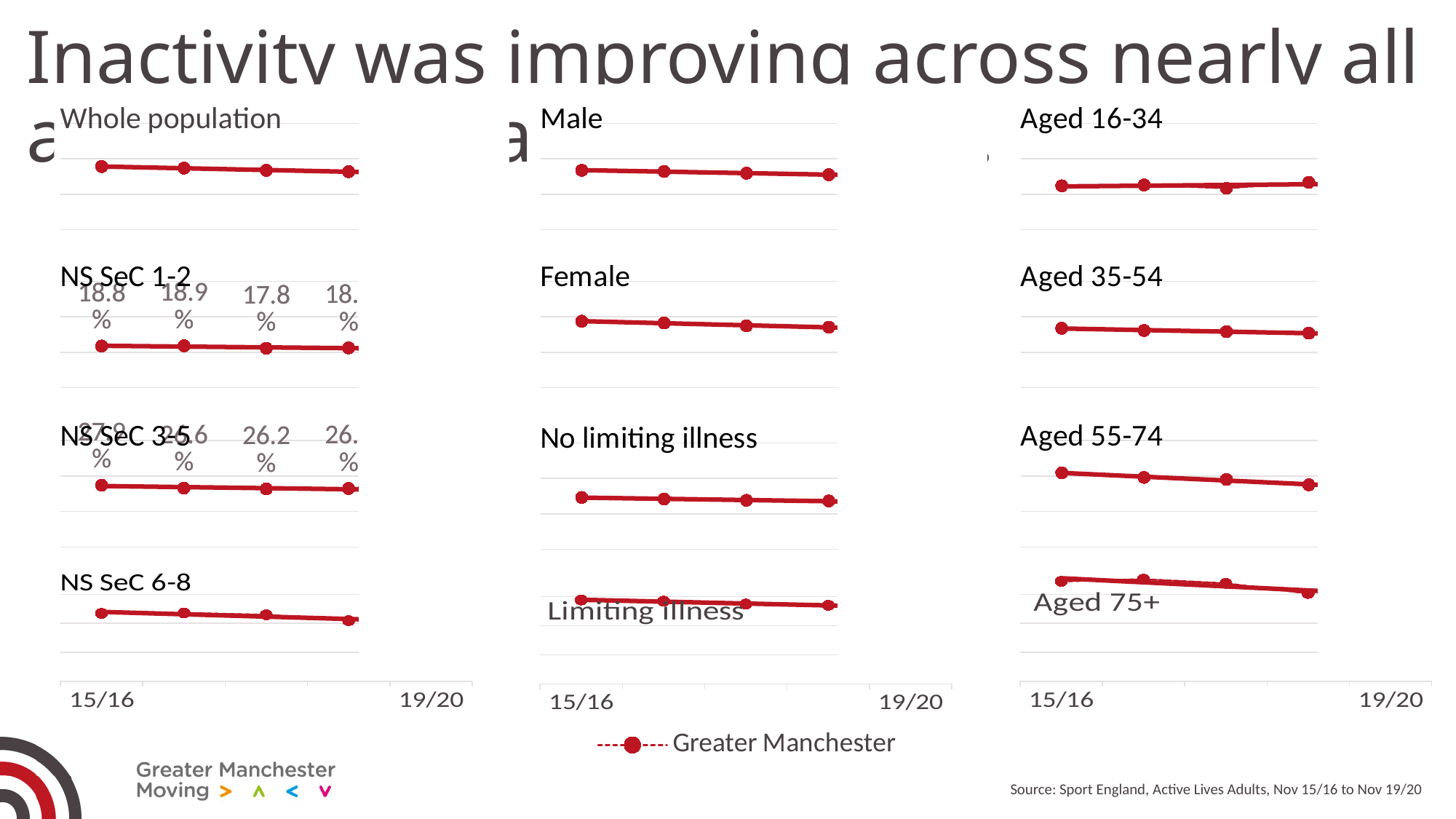
In the 'NS SeC 1-2' chart, what is the value of the second data point? 18.9% In the 'NS SeC 3-5' chart, what is the value of the third data point? 26.2% In the 'Aged 55-74' chart, do the values rise or fall from 15/16 to 19/20? fall What kind of chart is used for the 'Whole population' panel? line chart In the 'NS SeC 1-2' chart, what is the value of the third data point? 17.8% How many series does the legend list? 1 How many small charts are shown on the slide? 12 How many data points are plotted in the 'Whole population' chart? 4 In the 'NS SeC 1-2' chart, what is the value of the first data point (15/16)? 18.8% What is the name of the series shown in the legend? Greater Manchester In the 'NS SeC 1-2' chart, which is larger: the second data point or the third data point? the second data point (18.9%) In the 'NS SeC 1-2' chart, what is the difference between the second data point (18.9%) and the third data point (17.8%)? 1.1%